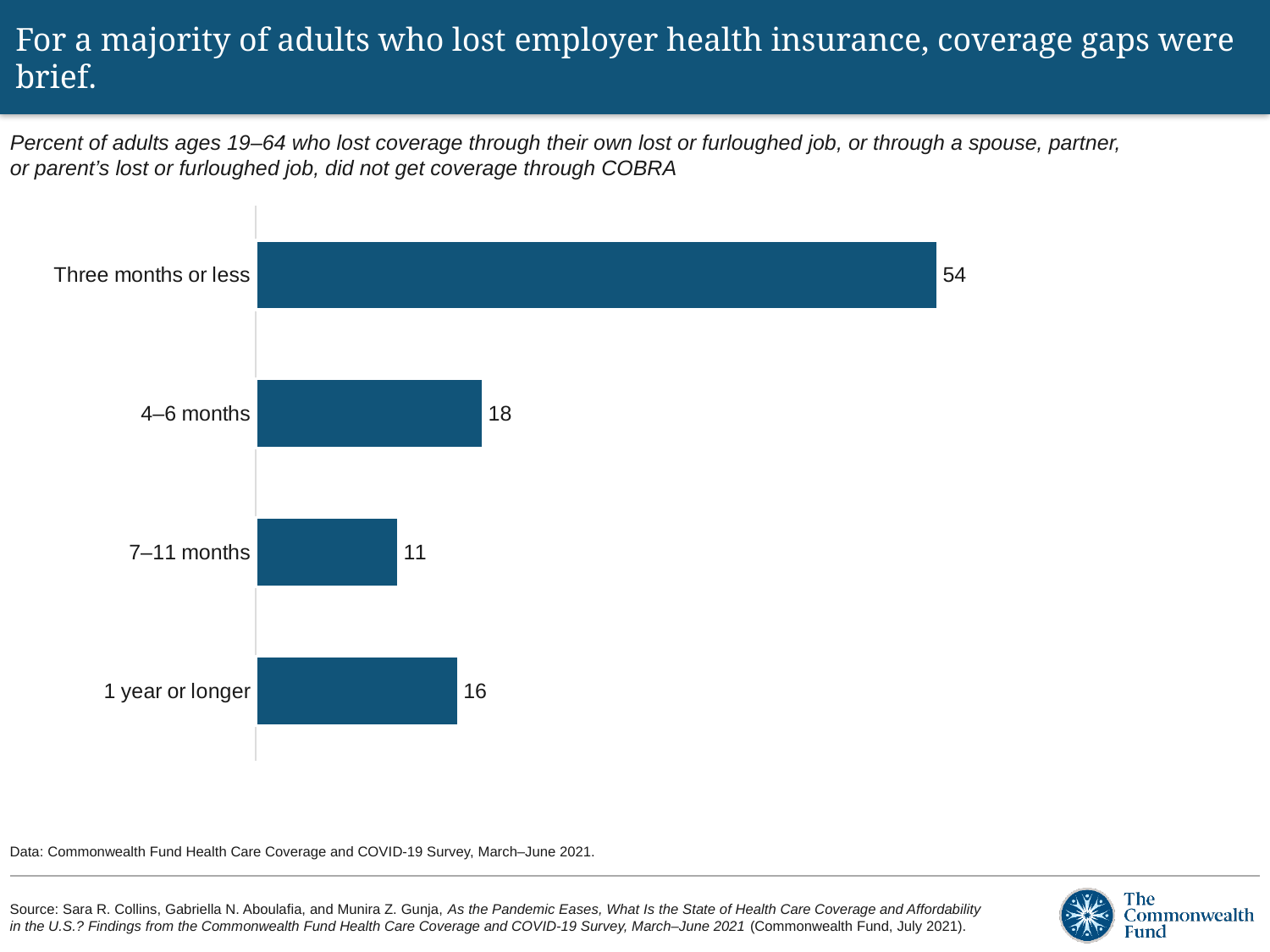
What is the title of the slide? For a majority of adults who lost employer health insurance, coverage gaps were brief. What is the value for '7–11 months'? 11 What is the difference between the values for 'Three months or less' and '4–6 months'? 36 What is the difference between the values for '1 year or longer' and '7–11 months'? 5 What kind of chart is shown on the slide? Bar chart What is the value for '4–6 months'? 18 What is the value for '1 year or longer'? 16 Which category has the lowest value? 7–11 months Which is larger, the value for '4–6 months' or the value for '1 year or longer'? 4–6 months Which category has the highest value? Three months or less What is the value for 'Three months or less'? 54 How many categories are shown in the chart? 4